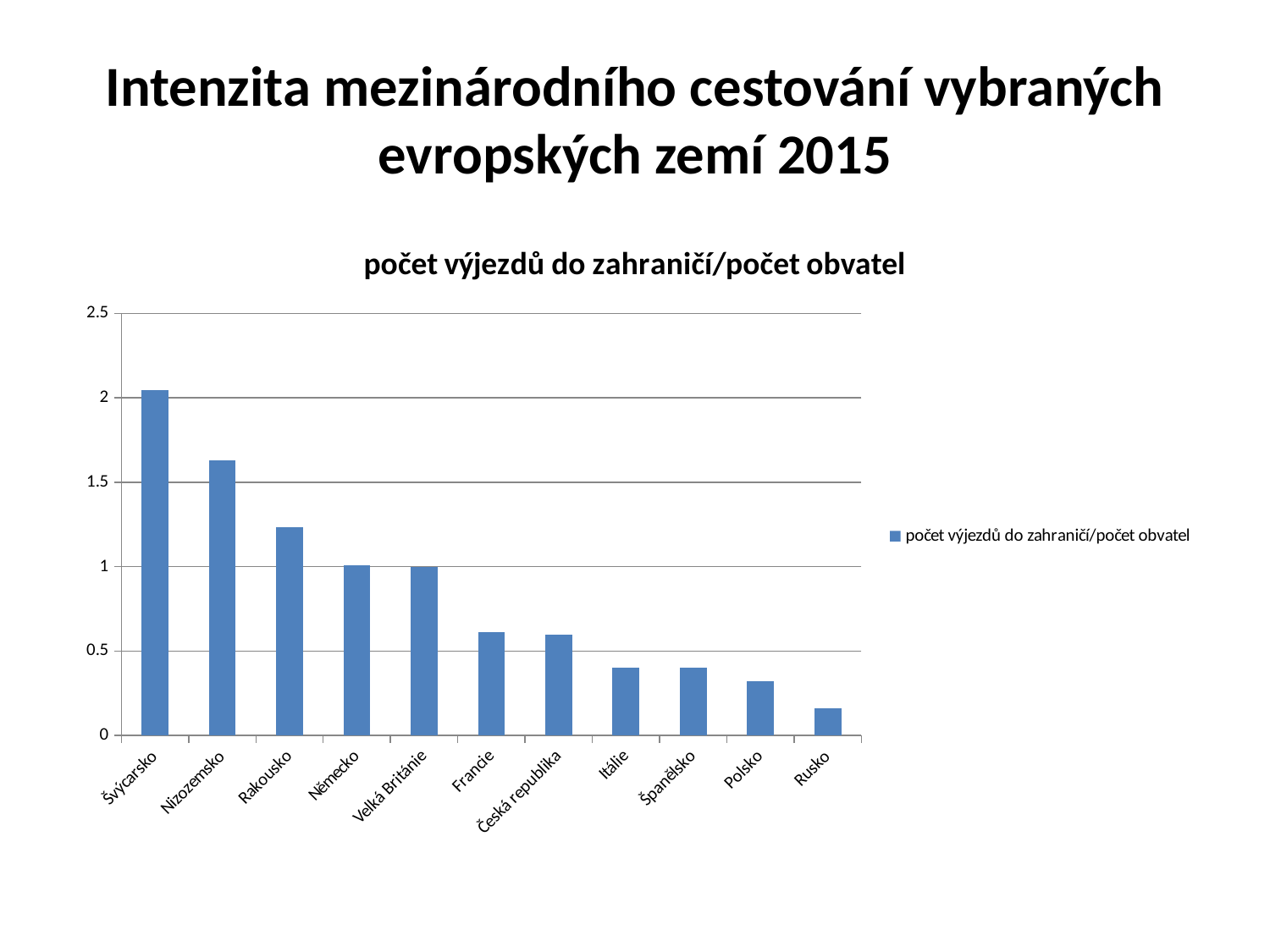
How many countries are shown on the x axis of the chart? 11 What kind of chart is shown on the slide? bar chart Is the value for Rusko greater or less than 0.5? less Which country has the lowest value in the chart? Rusko Is the value for Nizozemsko greater or less than 1.5? greater Which has the larger value, Francie or Polsko? Francie Which country has the highest value in the chart? Švýcarsko How many series does the legend list? 1 What is the title of the chart? počet výjezdů do zahraničí/počet obvatel Is the value for Rakousko greater or less than 1? greater Do the values rise or fall from left to right along the x axis? fall Which has the larger value, Nizozemsko or Rakousko? Nizozemsko